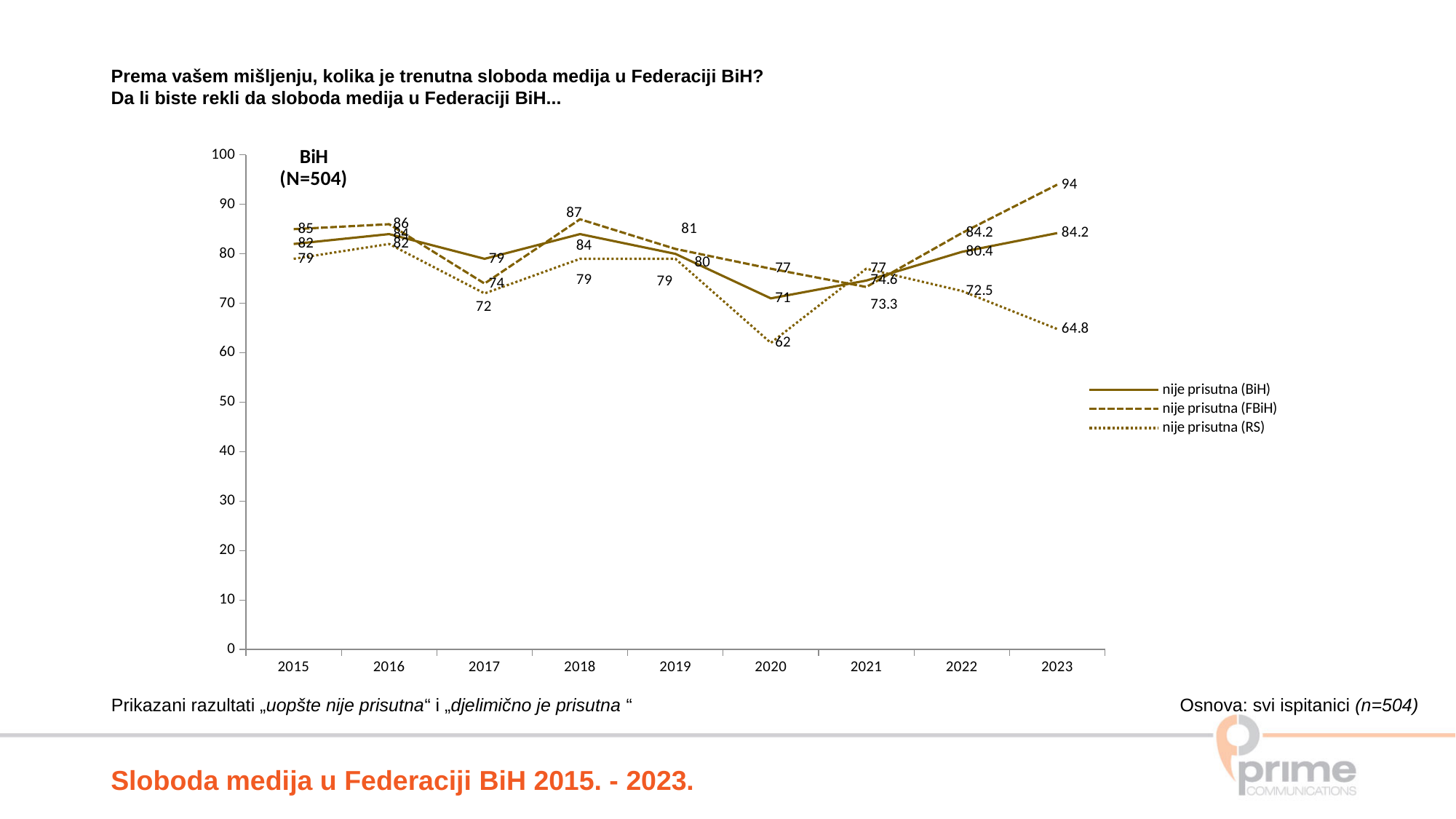
How many series does the legend list? 3 How many years are shown on the x axis? 9 In 2017, which series has the higher value: 'nije prisutna (BiH)' or 'nije prisutna (RS)'? nije prisutna (BiH) In which year does the 'nije prisutna (BiH)' series have its lowest value? 2020 What kind of chart is shown on the slide? line chart What is the value of the 'nije prisutna (RS)' series in 2020? 62 In which year does the 'nije prisutna (FBiH)' series reach its highest value? 2023 What is the difference between the 'nije prisutna (FBiH)' and 'nije prisutna (RS)' values in 2023? 29.2 What is the value of the 'nije prisutna (BiH)' series in 2022? 80.4 Does the 'nije prisutna (RS)' series rise or fall from 2021 to 2023? fall What sample size (N) is shown in the label at the top of the chart? N=504 What is the value of the 'nije prisutna (FBiH)' series in 2023? 94